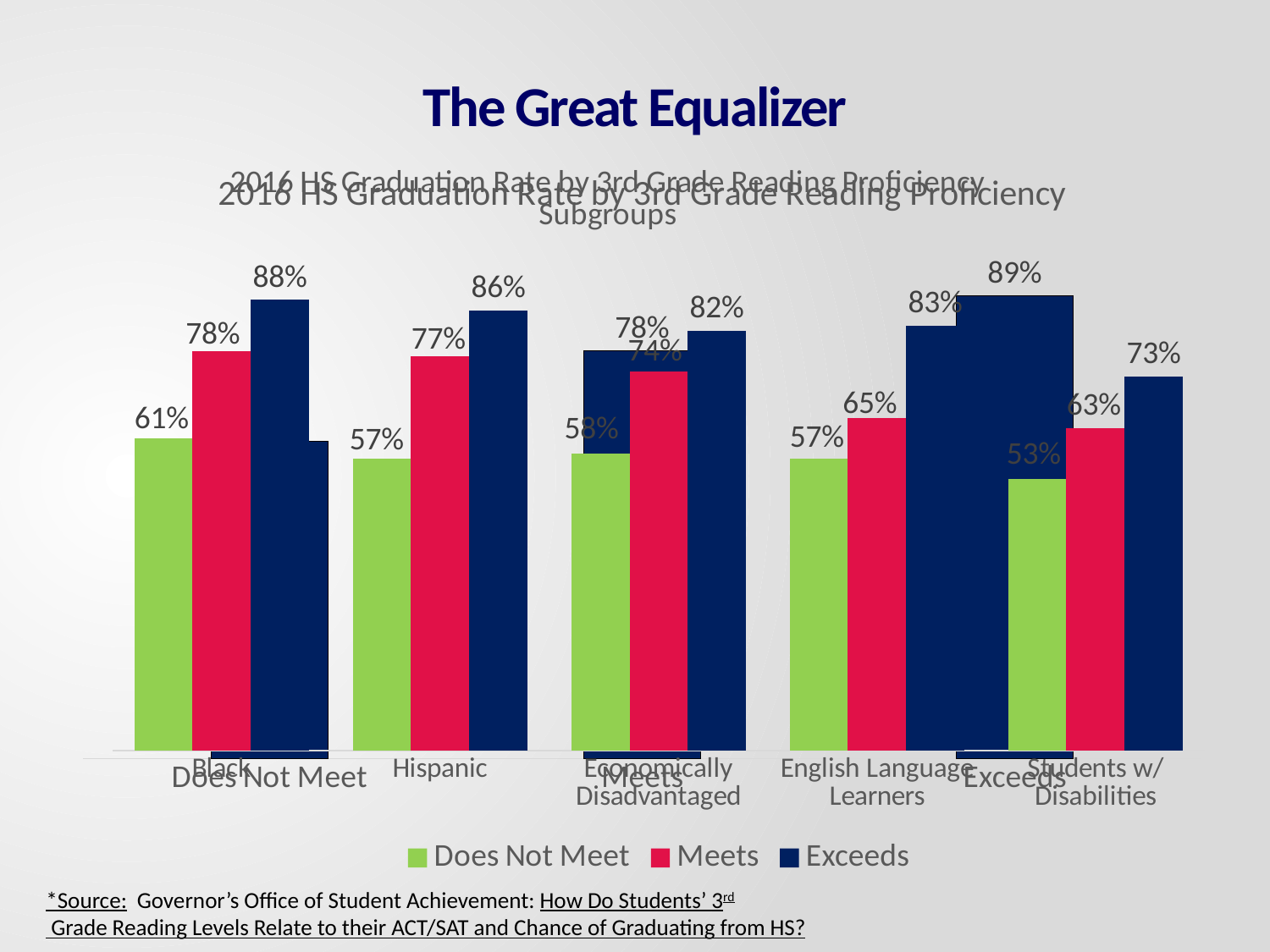
In the subgroups chart, which subgroup has the lowest Does Not Meet value? Students w/ Disabilities In the subgroups chart, which subgroup has the highest Exceeds value? Black In the subgroups chart, what is the Meets value for English Language Learners? 65% In the chart titled '2016 HS Graduation Rate by 3rd Grade Reading Proficiency Subgroups', what is the Exceeds value for Black students? 88% In the subgroups chart, which colour represents the Exceeds series? Dark blue How many subgroups are shown on the x axis of the subgroups chart? 5 What kind of chart is the subgroups chart? Bar chart In the subgroups chart, what is the Exceeds value for Students w/ Disabilities? 73% In the subgroups chart, what is the Does Not Meet value for Hispanic students? 57% How many series does the legend of the subgroups chart list? 3 In the subgroups chart, which is larger: the Meets value for Hispanic students or the Meets value for Students w/ Disabilities? Hispanic In the subgroups chart, what is the difference between the Exceeds and Does Not Meet values for Black students? 27%